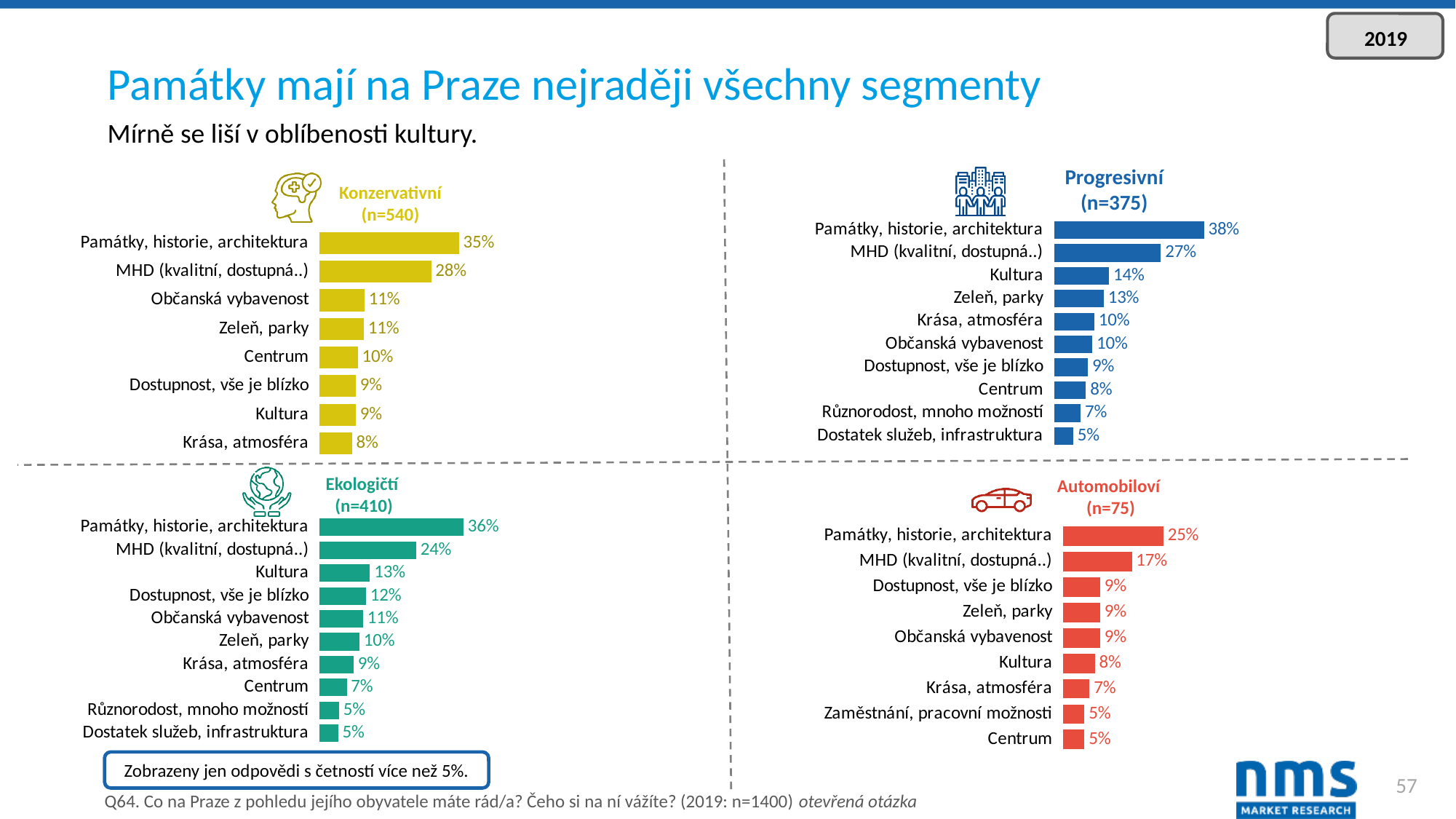
What is the sample size (n) shown for the Automobilovi segment? n=75 In the Ekologičtí chart, what is the difference between Památky, historie, architektura and MHD (kvalitní, dostupná..)? 12% In the Automobilovi chart, what is the value for Zaměstnání, pracovní možnosti? 5% In the Ekologičtí chart, what is the value for Dostupnost, vše je blízko? 12% In the Progresivní chart, what is the value for Kultura? 14% Which is larger: the value for Kultura in the Progresivní chart or the value for Kultura in the Konzervativní chart? Progresivní How many categories are shown in the Automobilovi chart? 9 In the Progresivní chart, which category has the highest value? Památky, historie, architektura In the Konzervativní chart, what is the value for MHD (kvalitní, dostupná..)? 28% What kind of chart is the Ekologičtí chart? Bar chart How many categories are shown in the Konzervativní chart? 8 In the Konzervativní chart, which category has the lowest value? Krása, atmosféra